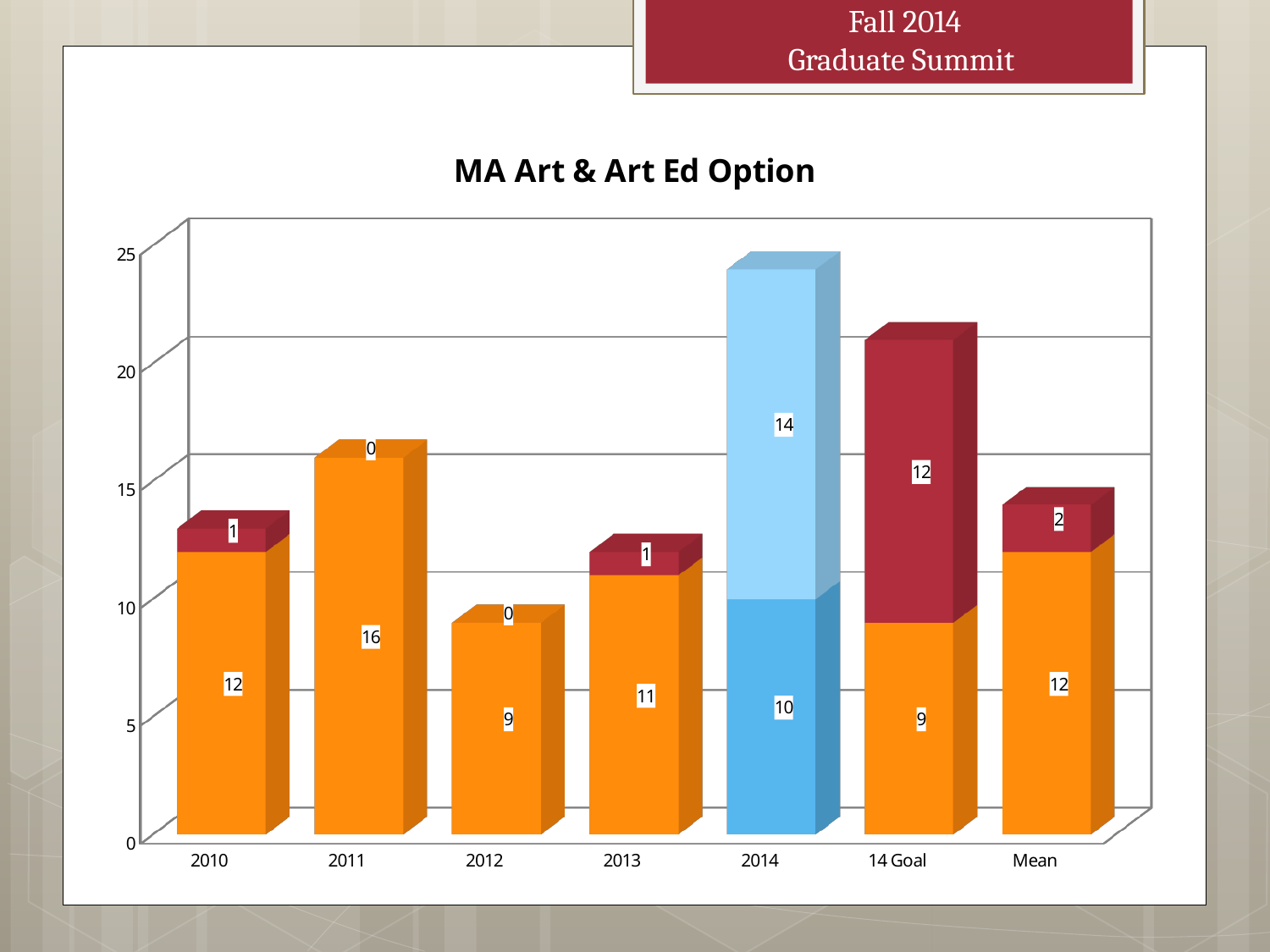
What is the total of the stacked bar for 2014? 24 What is the title of the chart? MA Art & Art Ed Option How many categories are shown on the x axis? 7 Which category has the shortest stacked bar overall? 2012 What is the difference between the bottom segment values for 2011 and 2012? 7 What is the total of the stacked bar for 14 Goal? 21 Which has a larger bottom segment value, 2010 or 2013? 2010 What is the value of the bottom segment of the 2011 bar? 16 What is the value of the bottom segment of the 14 Goal bar? 9 What is the value of the top segment of the 2014 bar? 14 Which category has the tallest stacked bar overall? 2014 Is the total height of the 2014 bar greater or less than 20? greater